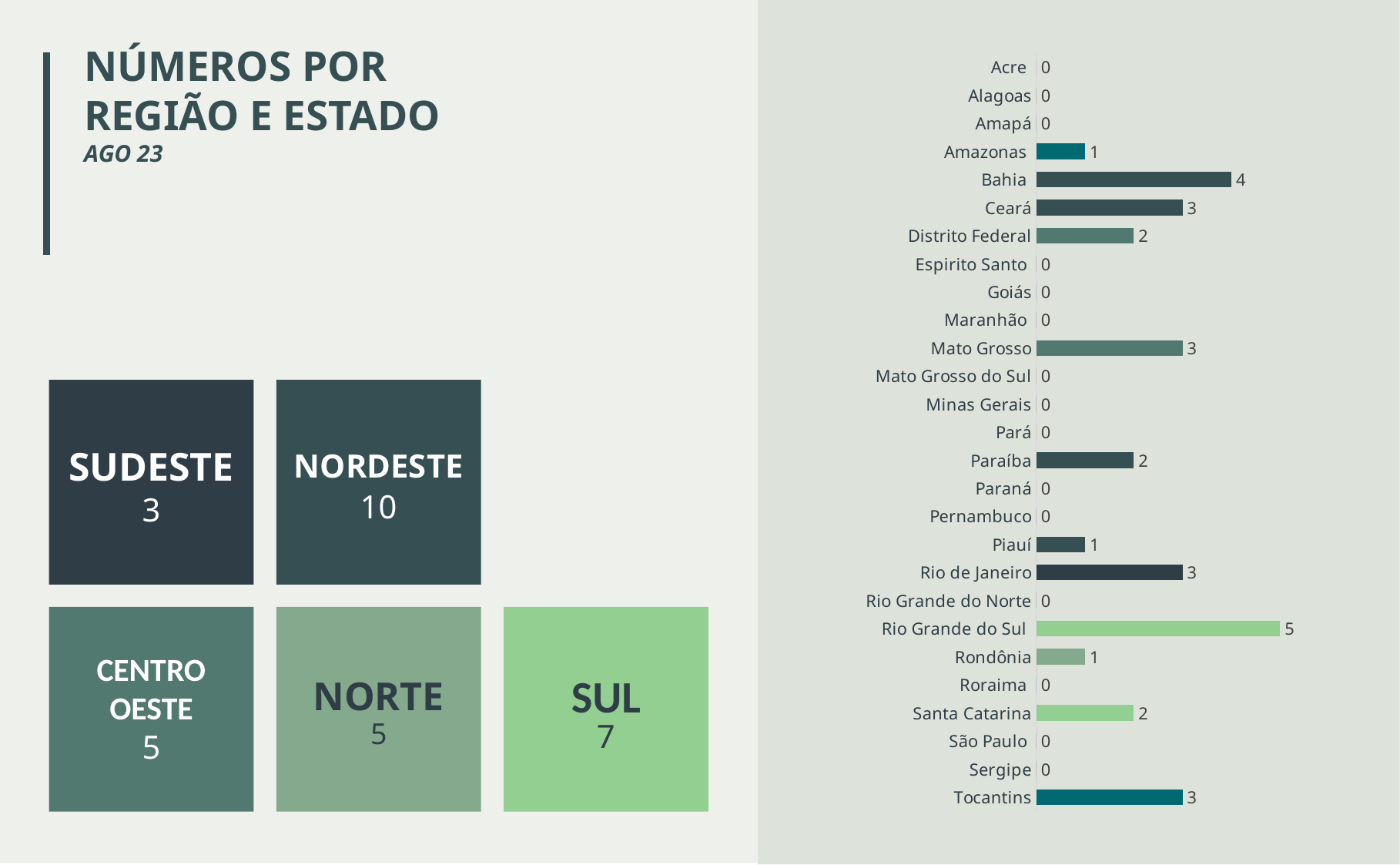
How many states are listed in the chart? 27 What is the difference between the values for Bahia and Piauí? 3 Which is larger, the value for Ceará or the value for Santa Catarina? Ceará What is the total of the values for Rio de Janeiro and Paraíba? 5 What is the value for Tocantins? 3 What is the value for Bahia? 4 How many states have a value of 0? 15 Which is larger, the value for Amazonas or the value for Mato Grosso? Mato Grosso Which state has the highest value? Rio Grande do Sul What is the value for Distrito Federal? 2 What kind of chart is shown on the slide? Bar chart What is the value for Rio Grande do Sul? 5